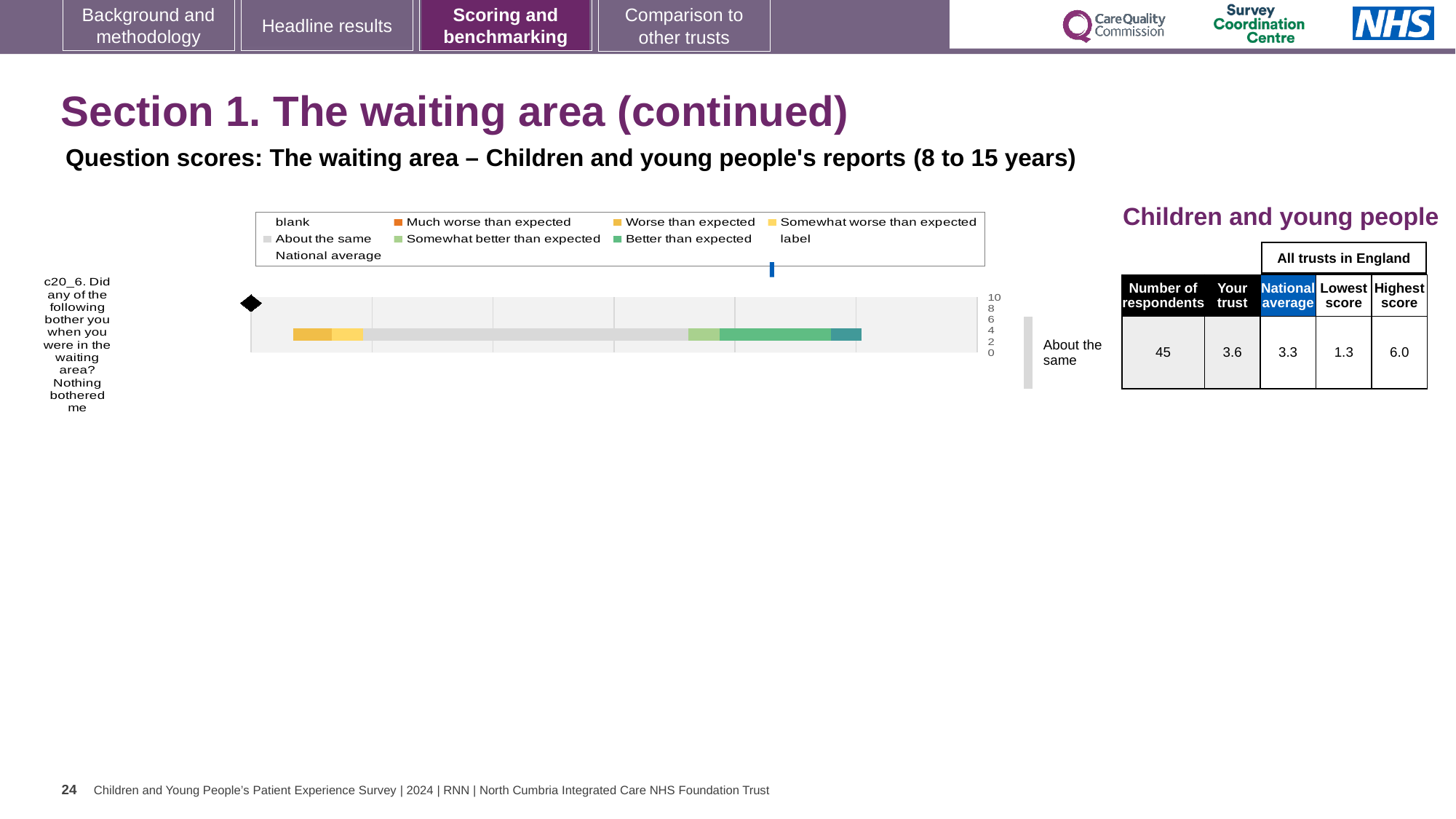
What is the difference between the highest and lowest scores among all trusts in England for question c20_6? 4.7 Which is larger for question c20_6, the 'Your trust' score or the national average? Your trust What rating is shown to the right of the bar for question c20_6? About the same What is the 'Your trust' score for question c20_6? 3.6 What is the national average score for question c20_6? 3.3 What is the lowest score among all trusts in England for question c20_6? 1.3 What is the question code of the item plotted in the chart? c20_6 What is the difference between the 'Your trust' score and the national average for question c20_6? 0.3 How many questions (categories) are plotted in the chart? 1 How many respondents answered question c20_6? 45 What is the highest score among all trusts in England for question c20_6? 6.0 What kind of chart is shown on the slide? bar chart